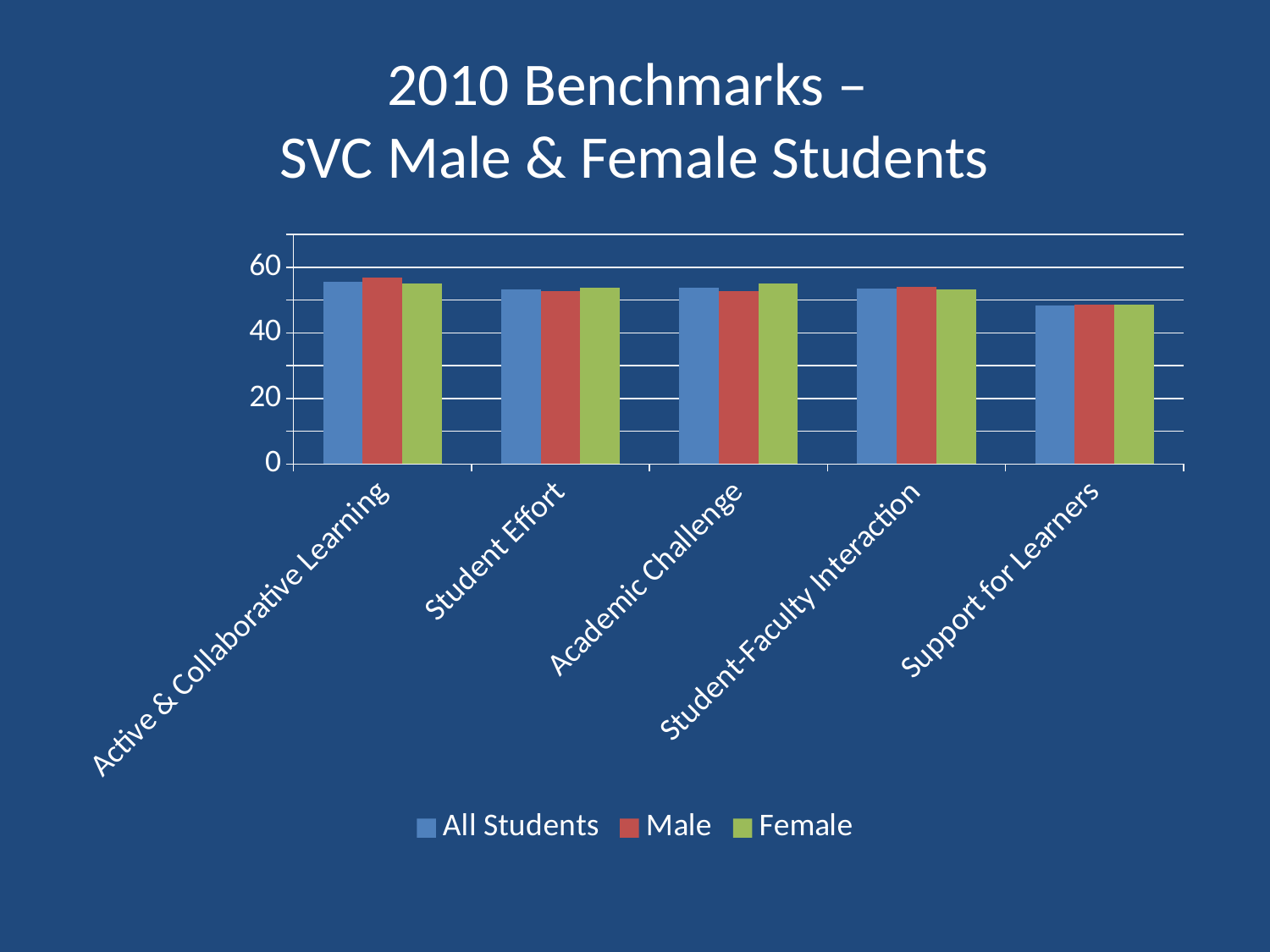
For Active & Collaborative Learning, which is larger: the Male value or the Female value? Male For the All Students series, which is larger: Active & Collaborative Learning or Support for Learners? Active & Collaborative Learning What is the title of the chart? 2010 Benchmarks – SVC Male & Female Students Which category has the highest value for the Male series? Active & Collaborative Learning How many benchmark categories are shown on the x axis? 5 What kind of chart is shown on the slide? bar chart How many series does the legend list? 3 Is the Male value for Active & Collaborative Learning greater or less than 40? greater Which category has the lowest value for the Male series? Support for Learners Which category has the lowest value for the Female series? Support for Learners Is the All Students value for Support for Learners greater or less than 60? less Which series are listed in the legend? All Students, Male, Female